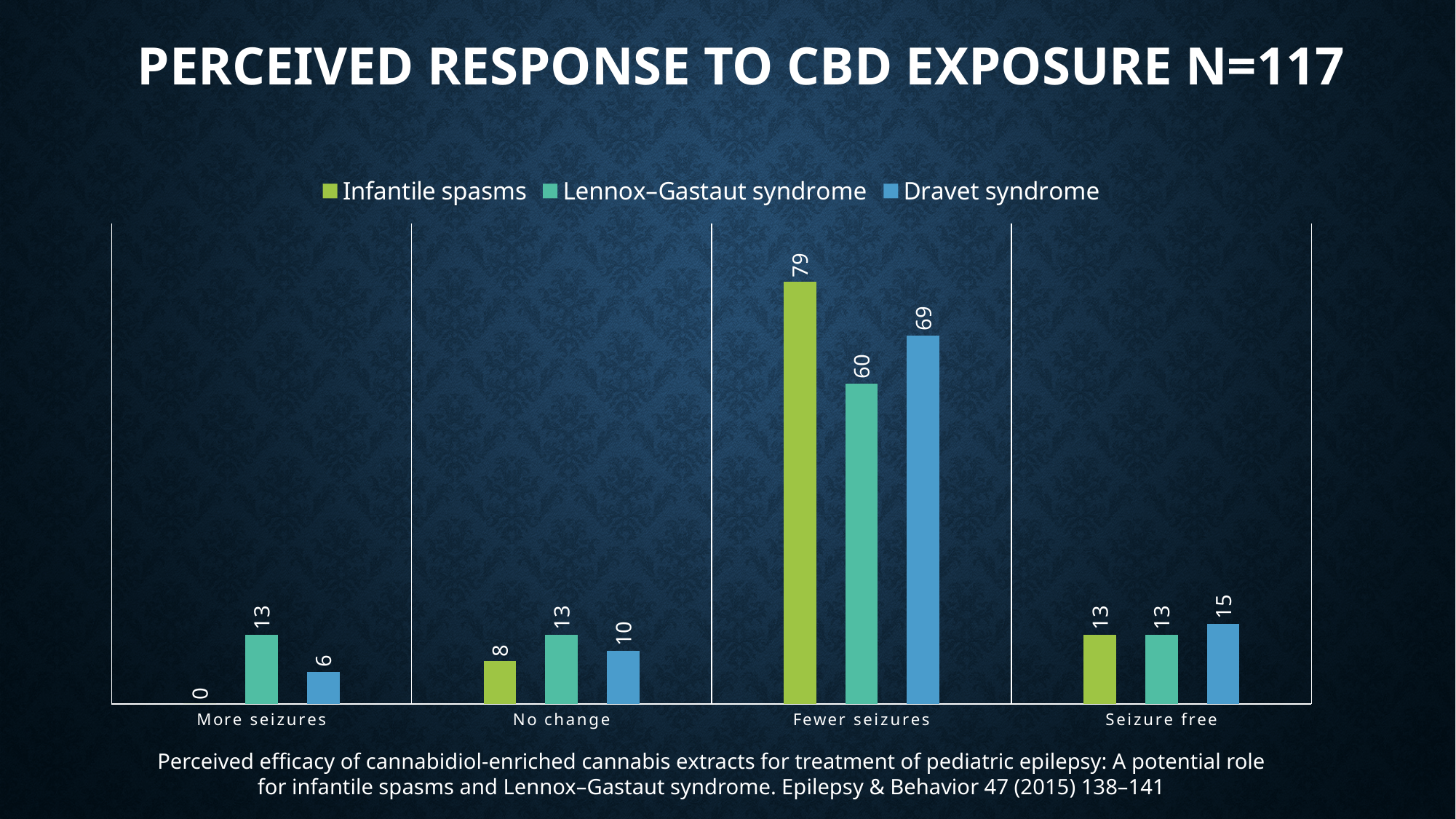
How many series does the legend list? 3 What is the difference between the Infantile spasms and Lennox–Gastaut syndrome values in the Fewer seizures category? 19 How many categories are shown on the x axis? 4 What is the value for Lennox–Gastaut syndrome in the No change category? 13 What is the value for Infantile spasms in the Fewer seizures category? 79 What is the value for Dravet syndrome in the More seizures category? 6 Which category has the lowest value for Infantile spasms? More seizures Which category has the highest value for Dravet syndrome? Fewer seizures What is the value for Dravet syndrome in the Seizure free category? 15 What kind of chart is shown on the slide? Bar chart In the No change category, which is larger: the value for Infantile spasms or the value for Dravet syndrome? Dravet syndrome What is the title of the chart? Perceived response to CBD exposure N=117